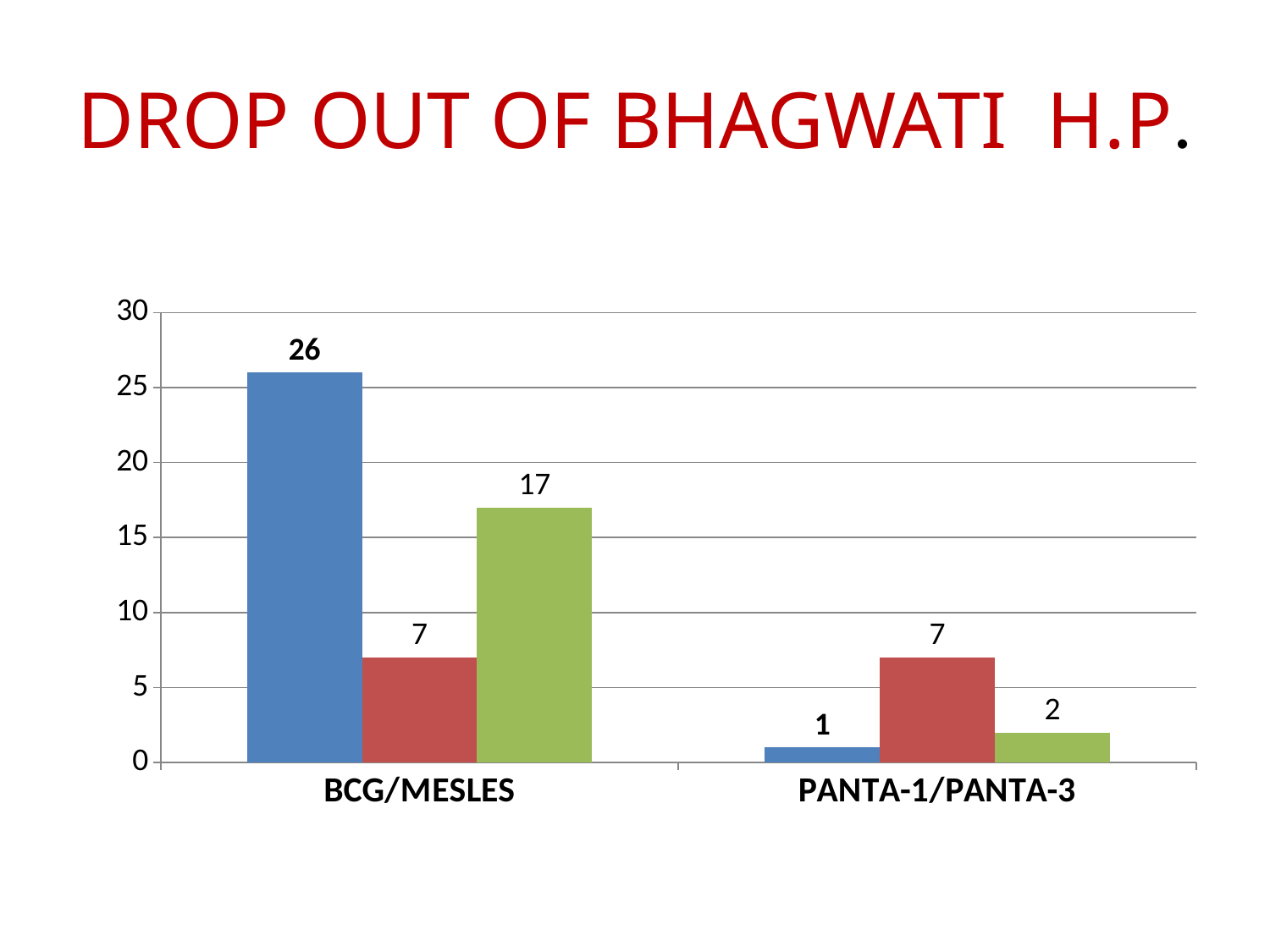
Which bar has the lowest value in the chart? the blue bar for PANTA-1/PANTA-3 (1) What is the value of the blue bar for BCG/MESLES? 26 What is the difference between the blue bar and the green bar for BCG/MESLES? 9 What is the value of the red bar for PANTA-1/PANTA-3? 7 How many categories are shown on the x axis? 2 What is the value of the green bar for BCG/MESLES? 17 What is the value of the blue bar for PANTA-1/PANTA-3? 1 Which bar has the highest value in the chart? the blue bar for BCG/MESLES (26) What type of chart is shown on the slide? bar chart What is the title of the slide? DROP OUT OF BHAGWATI H.P. Which is larger for PANTA-1/PANTA-3, the red bar or the green bar? the red bar What is the value of the green bar for PANTA-1/PANTA-3? 2